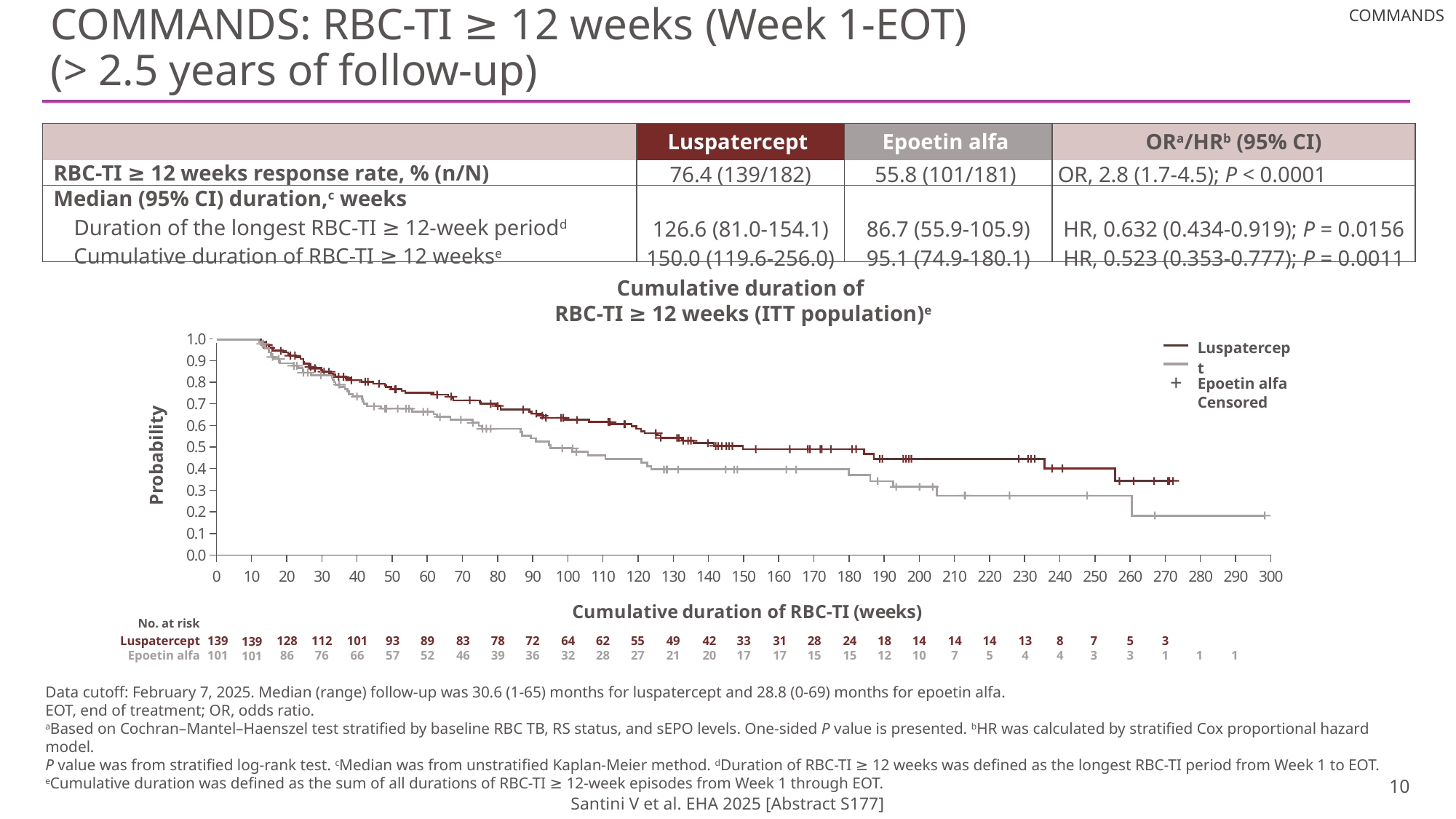
In the 'No. at risk' row, how many Epoetin alfa patients were at risk at 50 weeks? 57 In the 'No. at risk' row, how many Luspatercept patients were at risk at 100 weeks? 64 What is the number at risk for Luspatercept at 0 weeks? 139 Do the curves in the Kaplan-Meier chart rise or fall as cumulative duration increases? Fall At 100 weeks, is the Luspatercept probability greater or less than 0.5? greater What is the label of the x axis of the Kaplan-Meier chart? Cumulative duration of RBC-TI (weeks) At 150 weeks, which curve is higher in the Kaplan-Meier chart, Luspatercept or Epoetin alfa? Luspatercept What is the label of the y axis of the Kaplan-Meier chart? Probability How many treatment groups does the legend of the Kaplan-Meier chart list? 2 What is the difference between the Luspatercept and Epoetin alfa numbers at risk at 100 weeks? 32 What kind of chart is shown under the title 'Cumulative duration of RBC-TI ≥ 12 weeks (ITT population)'? Line chart (Kaplan-Meier curve) At 200 weeks, is the Epoetin alfa probability greater or less than 0.4? less